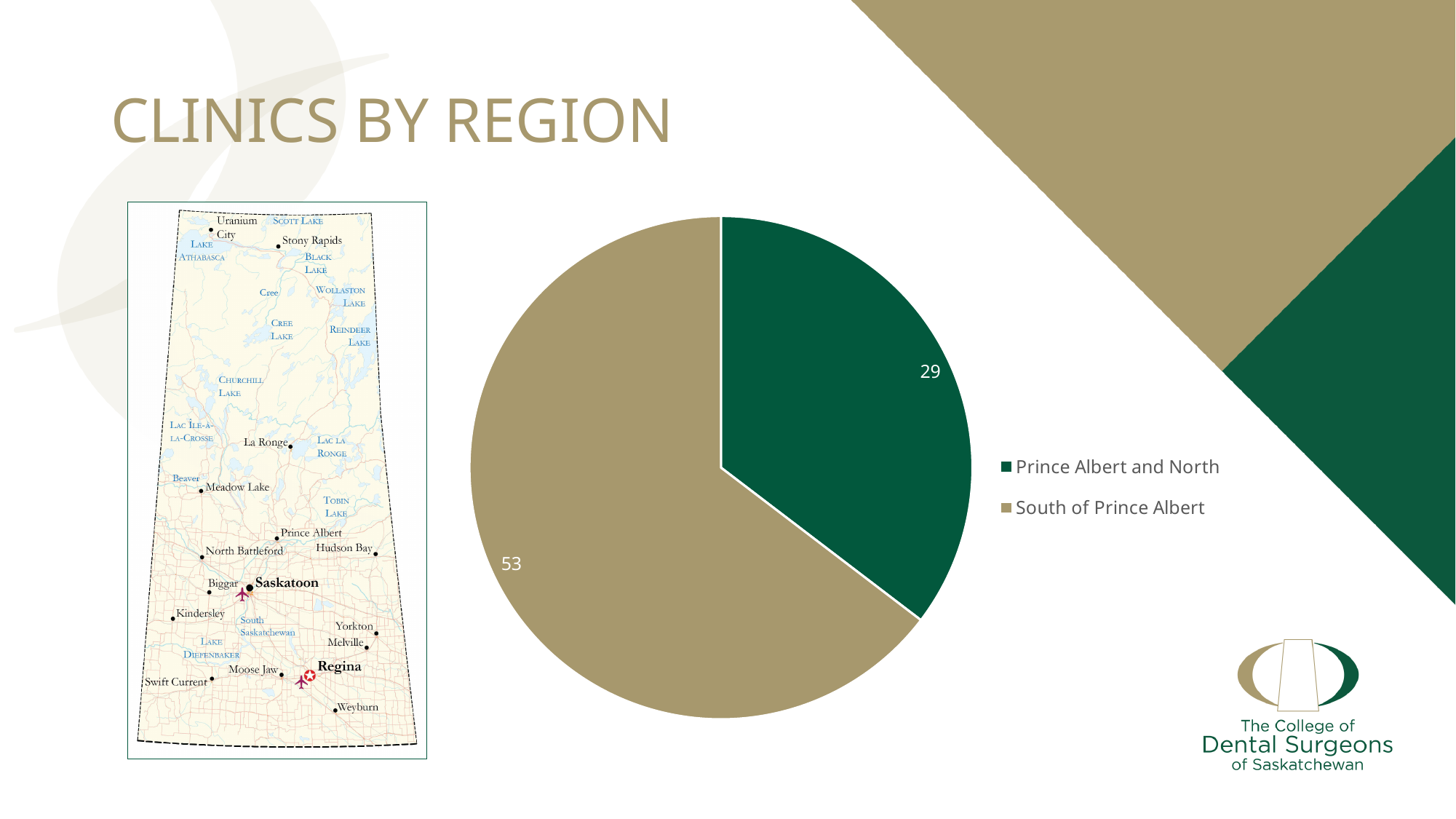
What is the difference between the number of clinics South of Prince Albert and in Prince Albert and North? 24 Which region has the larger number of clinics? South of Prince Albert What is the value for South of Prince Albert in the pie chart? 53 Which region has the smaller number of clinics? Prince Albert and North What type of chart is shown on the slide? pie chart What is the title of the slide containing the pie chart? CLINICS BY REGION What is the value for Prince Albert and North in the pie chart? 29 What is the total number of clinics shown in the pie chart? 82 Is the value for South of Prince Albert larger or smaller than the value for Prince Albert and North? larger How many slices does the pie chart have? 2 How many entries does the legend list? 2